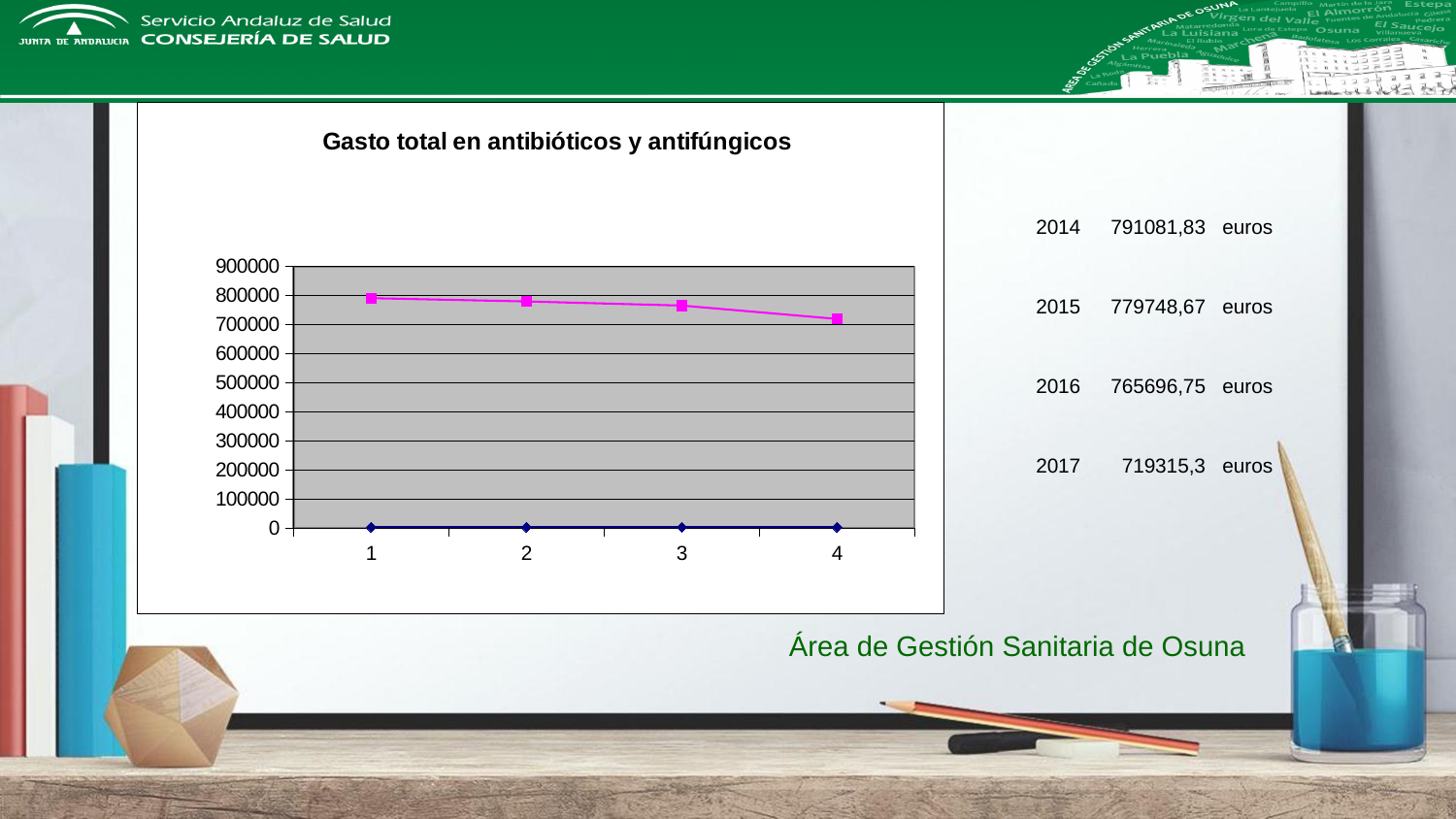
What is the title of the chart? Gasto total en antibióticos y antifúngicos Which is larger on the magenta line, the value at point 2 or the value at point 4? point 2 Does the magenta line rise or fall from point 1 to point 4? fall How many points are plotted along the x axis of the chart? 4 Is the value of the magenta line at point 1 greater or less than 700000? greater Which is larger on the magenta line, the value at point 1 or the value at point 4? point 1 What is the highest value shown on the y axis of the chart? 900000 Is the value of the magenta line at point 3 greater or less than 700000? greater At which x-axis point does the magenta line reach its lowest value? 4 Is the value of the magenta line at point 4 greater or less than 800000? less What kind of chart is shown on the slide? line chart